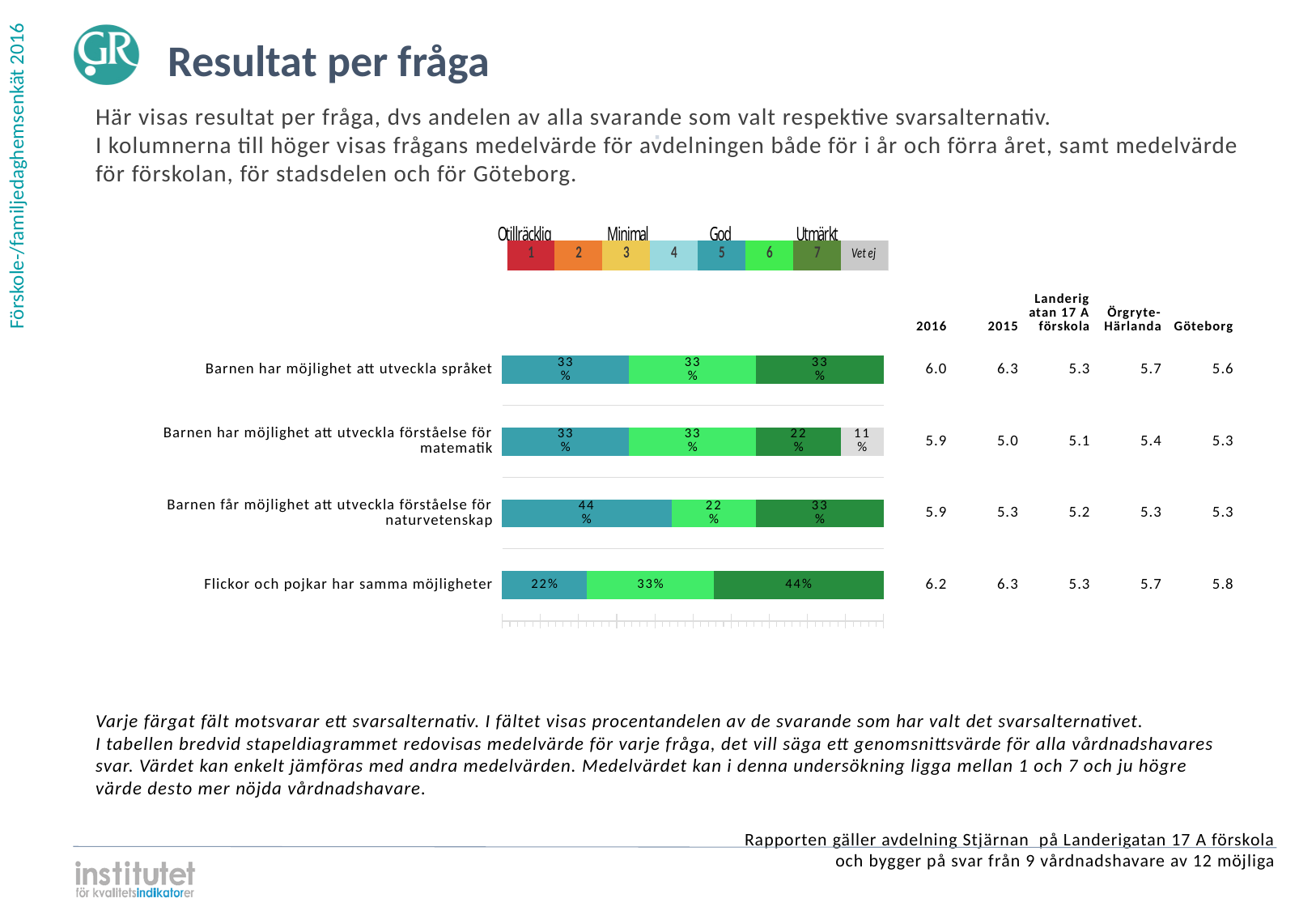
Which question is the only one with a 'Vet ej' segment in its bar? Barnen har möjlighet att utveckla förståelse för matematik What label does the legend give to answer option 7? Utmärkt How many answer options does the legend above the chart list, including 'Vet ej'? 8 For 'Barnen får möjlighet att utveckla förståelse för naturvetenskap', which is larger: the share for option 5 or the share for option 6? Option 5 What kind of chart is used to show the results per question? Stacked bar chart What is the 2015 mean value for 'Barnen har möjlighet att utveckla förståelse för matematik'? 5.0 What percentage answered 'Vet ej' for 'Barnen har möjlighet att utveckla förståelse för matematik'? 11% Which question has the highest 2016 mean value in the table next to the chart? Flickor och pojkar har samma möjligheter What percentage of respondents chose option 5 (teal) for 'Barnen får möjlighet att utveckla förståelse för naturvetenskap'? 44% What percentage of respondents chose option 7 (dark green) for 'Flickor och pojkar har samma möjligheter'? 44% How many questions (categories) are shown in the bar chart? 4 What is the difference between the option 7 share and the option 5 share for 'Flickor och pojkar har samma möjligheter'? 22%